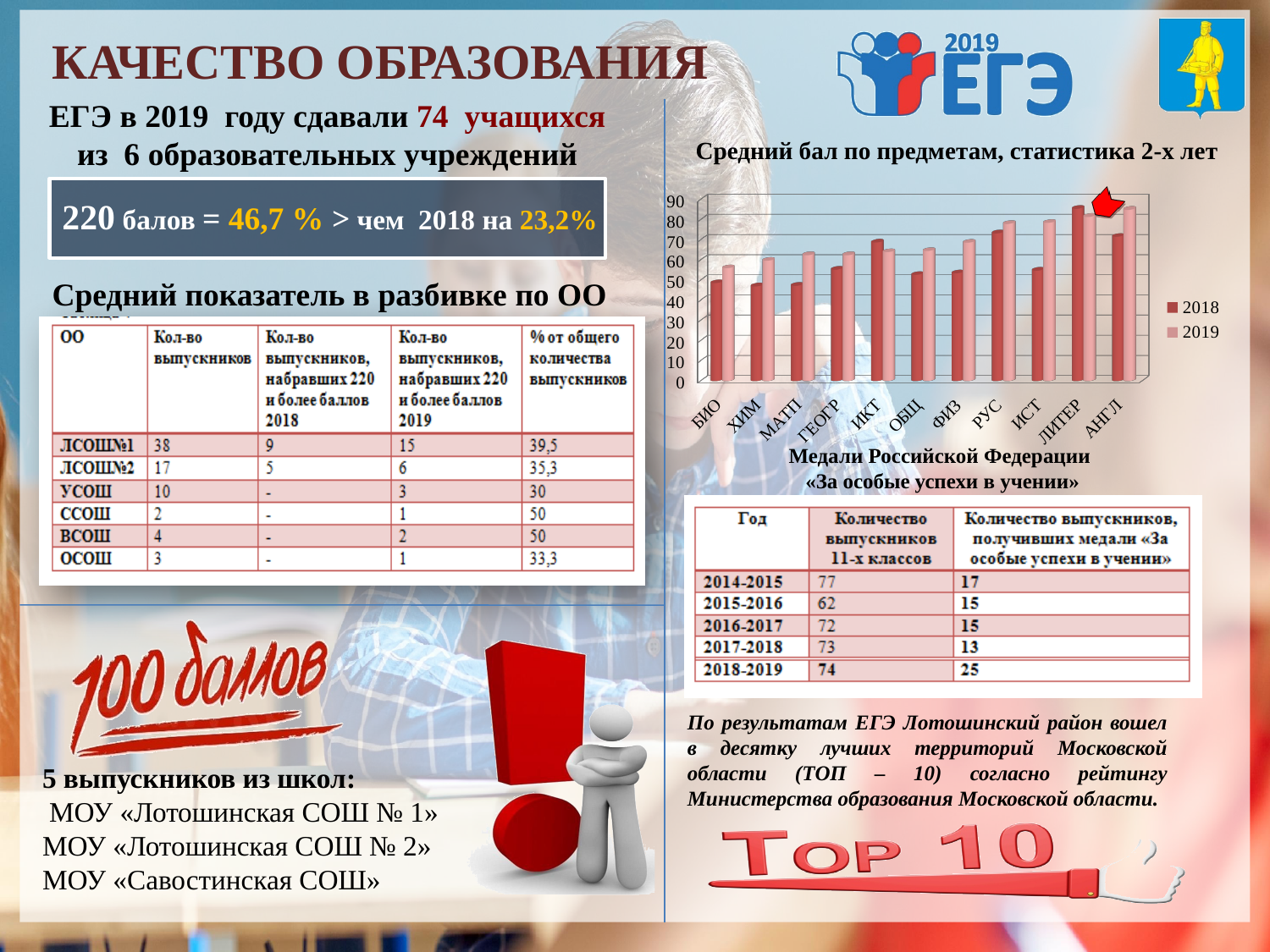
In the chart "Средний бал по предметам, статистика 2-х лет", which subject has the highest value for 2018? ЛИТЕР What kind of chart is used for "Средний бал по предметам, статистика 2-х лет"? bar chart How many series does the legend of the chart "Средний бал по предметам, статистика 2-х лет" list? 2 In the chart "Средний бал по предметам, статистика 2-х лет", which year has the larger value for ИКТ, 2018 or 2019? 2018 In the chart "Средний бал по предметам, статистика 2-х лет", is the 2019 value for РУС greater or less than 70? greater What are the two legend entries of the chart "Средний бал по предметам, статистика 2-х лет"? 2018 and 2019 In the chart "Средний бал по предметам, статистика 2-х лет", which year has the larger value for ИСТ, 2018 or 2019? 2019 How many subject categories are shown on the x axis of the chart "Средний бал по предметам, статистика 2-х лет"? 11 In the chart "Средний бал по предметам, статистика 2-х лет", which subject has the lowest value for 2019? БИО In the chart "Средний бал по предметам, статистика 2-х лет", is the 2019 value for БИО greater or less than 60? less In the chart "Средний бал по предметам, статистика 2-х лет", is the 2018 value for ЛИТЕР greater or less than 80? greater